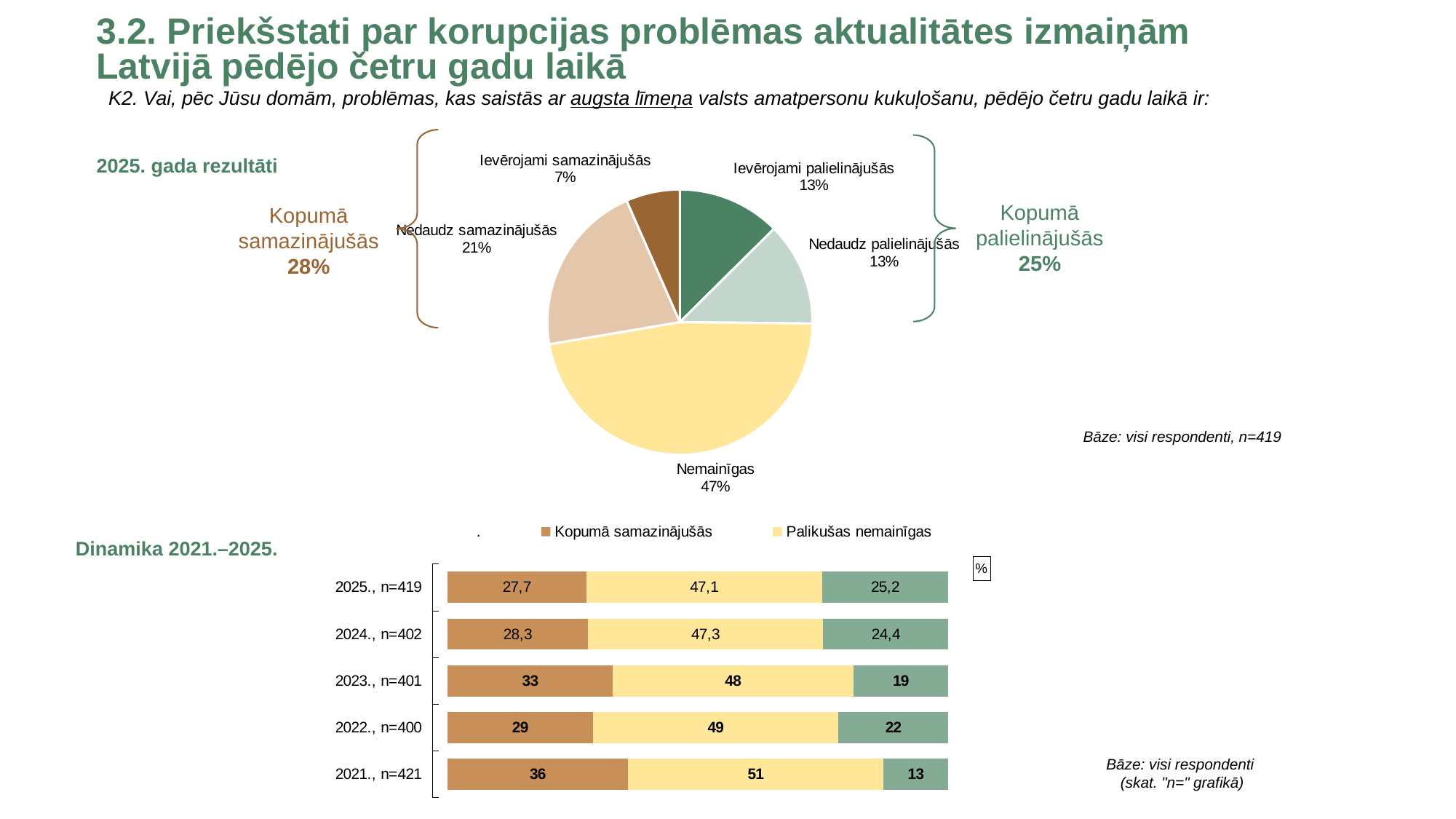
In the Dinamika 2021.–2025. chart, how many bars (years) are shown? 5 In the Dinamika 2021.–2025. chart, what is the value of Kopumā samazinājušās for 2021., n=421? 36 In the pie chart (2025. gada rezultāti), how many slices are there? 5 In the pie chart (2025. gada rezultāti), which category has the largest slice? Nemainīgas In the Dinamika 2021.–2025. chart, is the Kopumā samazinājušās value larger for 2025., n=419 or for 2024., n=402? 2024., n=402 In the pie chart (2025. gada rezultāti), which category has the smallest slice? Ievērojami samazinājušās What kind of chart is the top chart (2025. gada rezultāti)? Pie chart In the Dinamika 2021.–2025. chart, what is the difference between the Kopumā samazinājušās values for 2023., n=401 and 2022., n=400? 4 In the pie chart (2025. gada rezultāti), what share is labelled for Nemainīgas? 47% In the Dinamika 2021.–2025. chart, what is the value of Palikušas nemainīgas for 2024., n=402? 47,3 In the Dinamika 2021.–2025. chart, does the Palikušas nemainīgas value rise or fall from 2021 to 2025? Fall In the Dinamika 2021.–2025. chart, which year has the highest value for Kopumā samazinājušās? 2021., n=421